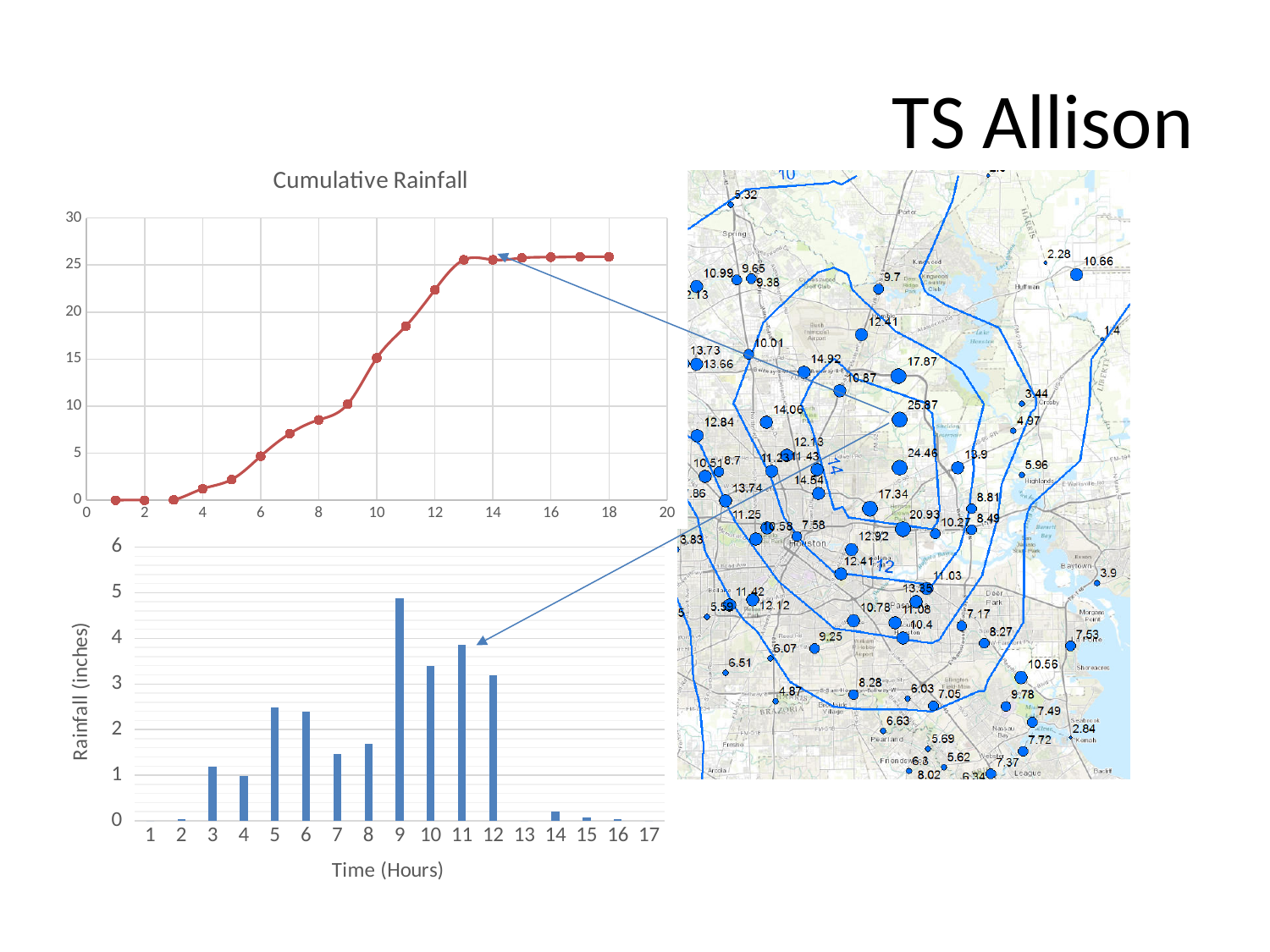
What is the y-axis label of the bottom bar chart? Rainfall (inches) In the bottom bar chart, is the value for hour 7 greater or less than 2? less In the top "Cumulative Rainfall" chart, do the values rise or fall from hour 1 to hour 13? rise In the bottom bar chart, is the value for hour 9 greater or less than 4? greater What kind of chart is the top chart titled "Cumulative Rainfall"? line chart In the bottom bar chart, which hour has the highest rainfall? 9 In the bottom bar chart, which is larger, the value for hour 9 or the value for hour 11? hour 9 In the top "Cumulative Rainfall" chart, is the value at hour 12 greater or less than 20? greater How many data points are plotted in the top "Cumulative Rainfall" chart? 18 What kind of chart is the bottom chart with the x axis "Time (Hours)"? bar chart In the bottom bar chart, which is larger, the value for hour 5 or the value for hour 7? hour 5